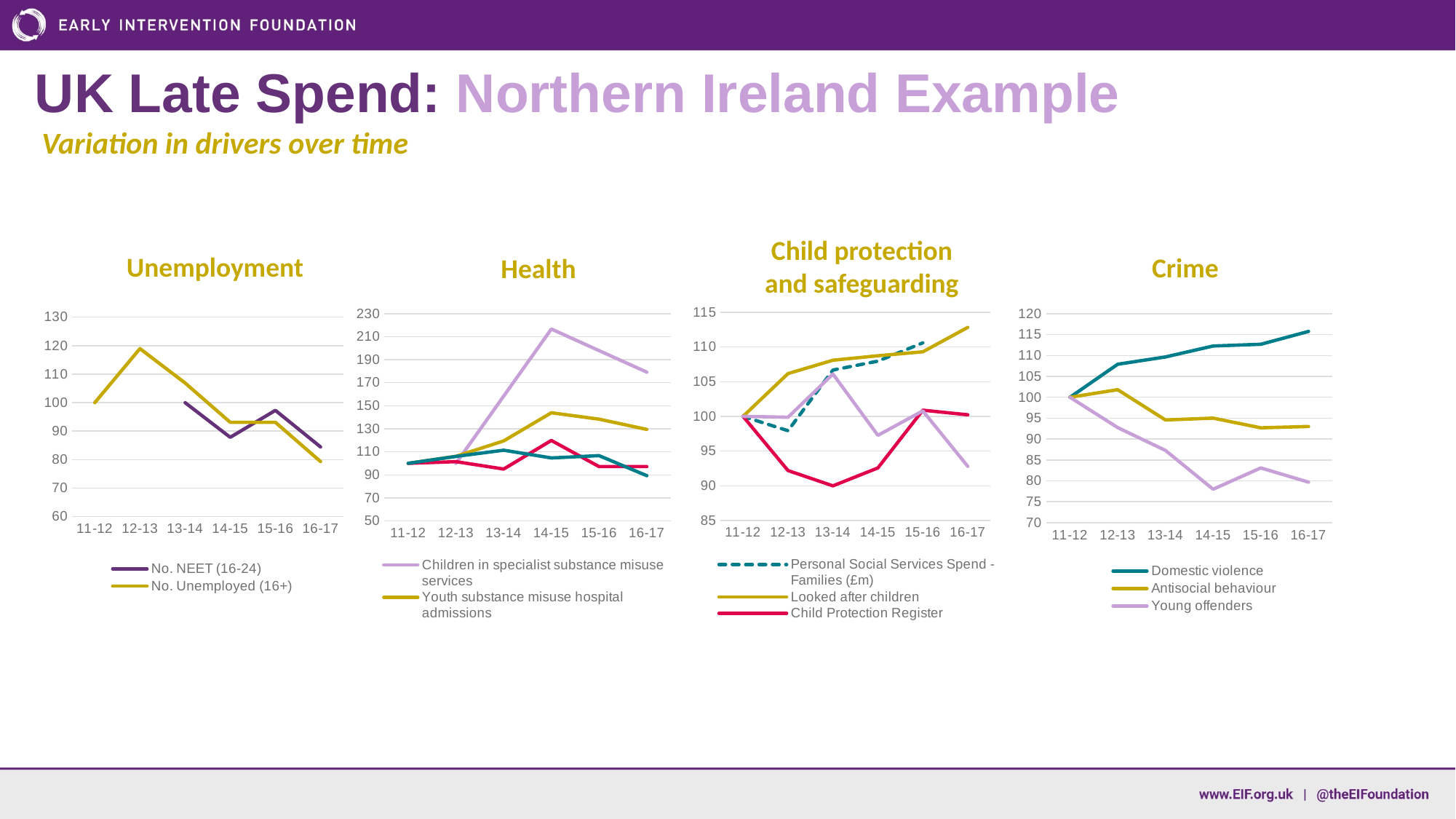
In the Unemployment chart, in which period is No. Unemployed (16+) highest? 12-13 In the Health chart, is the value for Children in specialist substance misuse services in 14-15 greater or less than 190? greater In the Child protection and safeguarding chart, is the value for Child Protection Register in 13-14 greater or less than 95? less In the Crime chart, what is the value for Domestic violence in 11-12? 100 How many series does the legend of the Unemployment chart list? 2 In the Health chart, which series has the highest value in 14-15? Children in specialist substance misuse services In the Crime chart, does the Domestic violence line rise or fall from 11-12 to 16-17? rise How many series does the legend of the Health chart list? 2 How many time periods are shown on the x axis of the Unemployment chart? 6 In the Child protection and safeguarding chart, does the Looked after children line rise or fall from 11-12 to 16-17? rise What kind of chart is the Unemployment chart? line chart In the Unemployment chart, is the value for No. Unemployed (16+) in 12-13 greater or less than 110? greater